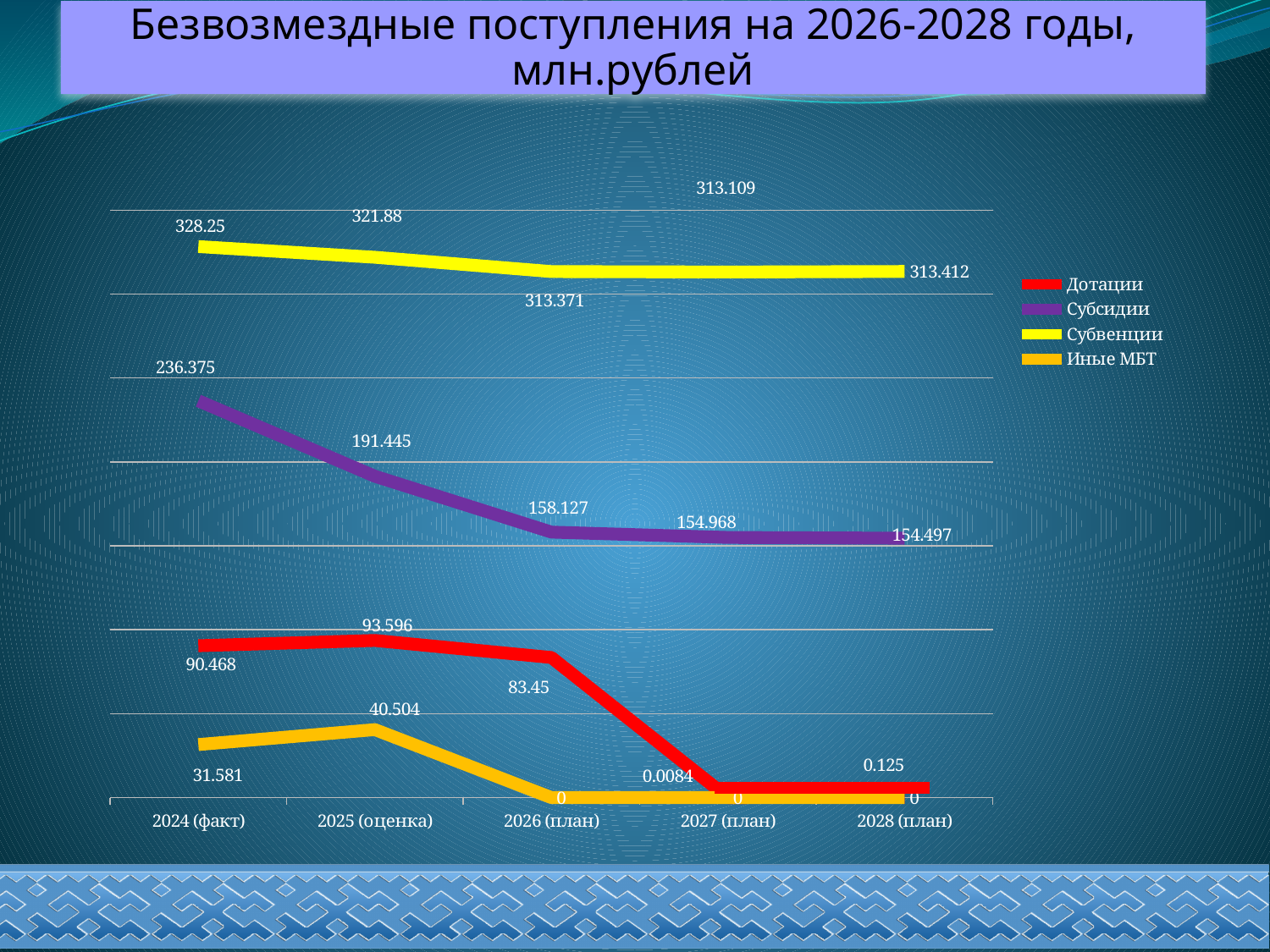
What is the value for Субвенции in 2024 (факт)? 328.25 How many categories are shown on the x axis? 5 In which category is the value for Субсидии the highest? 2024 (факт) What is the value for Субсидии in 2026 (план)? 158.127 In which category is the value for Дотации the lowest? 2027 (план) What kind of chart is shown on the slide? line chart How many series does the legend list? 4 What is the value for Дотации in 2027 (план)? 0.0084 What is the difference between the Субсидии values for 2024 (факт) and 2025 (оценка)? 44.93 Does the Субсидии series rise or fall from 2024 (факт) to 2028 (план)? fall Which is larger: Дотации in 2025 (оценка) or Дотации in 2026 (план)? 2025 (оценка) What is the value for Иные МБТ in 2025 (оценка)? 40.504